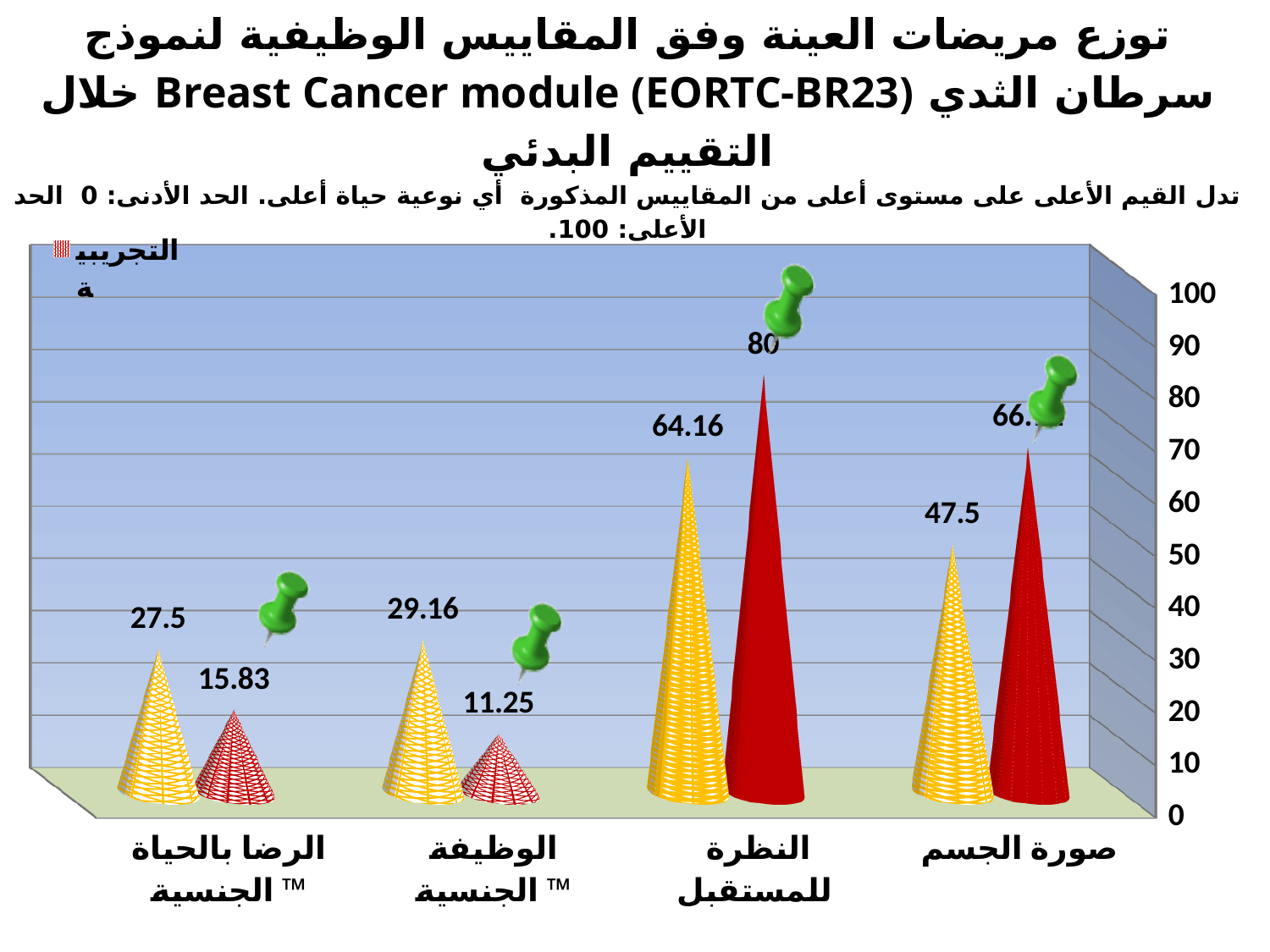
What is the value of the yellow series for الوظيفة الجنسية? 29.16 How many categories are shown on the x axis? 4 What is the value of the red series for الوظيفة الجنسية? 11.25 What is the value of the yellow series for صورة الجسم? 47.5 What is the value of the red series for الرضا بالحياة الجنسية? 15.83 What is the difference between the yellow and red values for الرضا بالحياة الجنسية? 11.67 For صورة الجسم, which series has the larger value, yellow or red? red Which category has the highest value in the yellow series? النظرة للمستقبل What is the value of the red series for النظرة للمستقبل? 80 Is the red series value for صورة الجسم greater or less than 60? greater What is the value of the yellow series for النظرة للمستقبل? 64.16 Which category has the lowest value in the red series? الوظيفة الجنسية